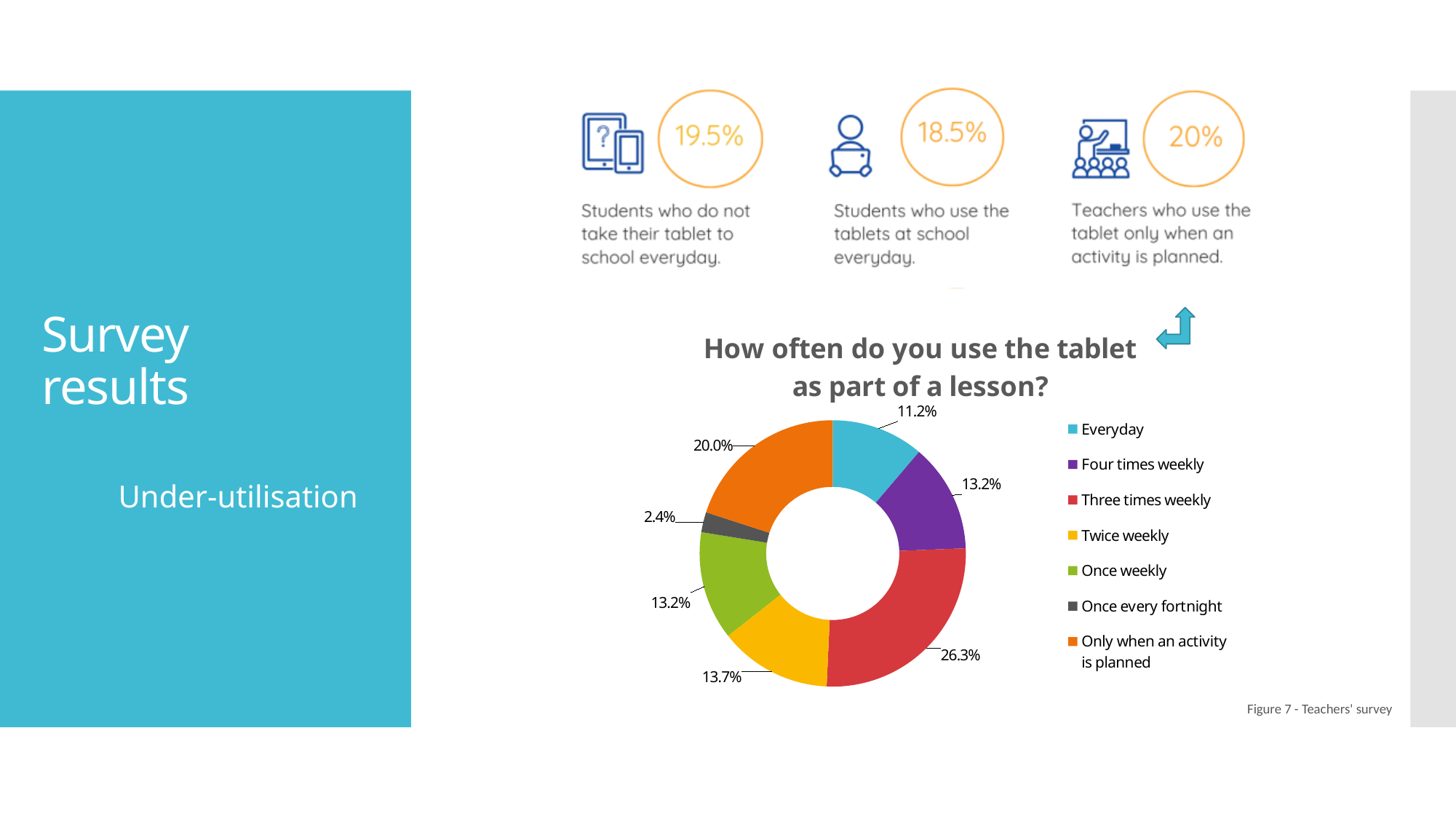
What percentage of teachers use the tablet once every fortnight? 2.4% What is the title of the chart on the slide? How often do you use the tablet as part of a lesson? Which is larger, the share for Twice weekly or the share for Everyday? Twice weekly How many categories does the doughnut chart show? 7 Which category has the smallest share of the doughnut chart? Once every fortnight What kind of chart is shown on the slide? Doughnut chart How many entries does the legend of the doughnut chart list? 7 What percentage of teachers use the tablet only when an activity is planned? 20.0% What is the difference between the share for Three times weekly and the share for Only when an activity is planned? 6.3% What percentage of teachers use the tablet as part of a lesson everyday? 11.2% Which category has the largest share of the doughnut chart? Three times weekly What percentage of teachers use the tablet three times weekly? 26.3%